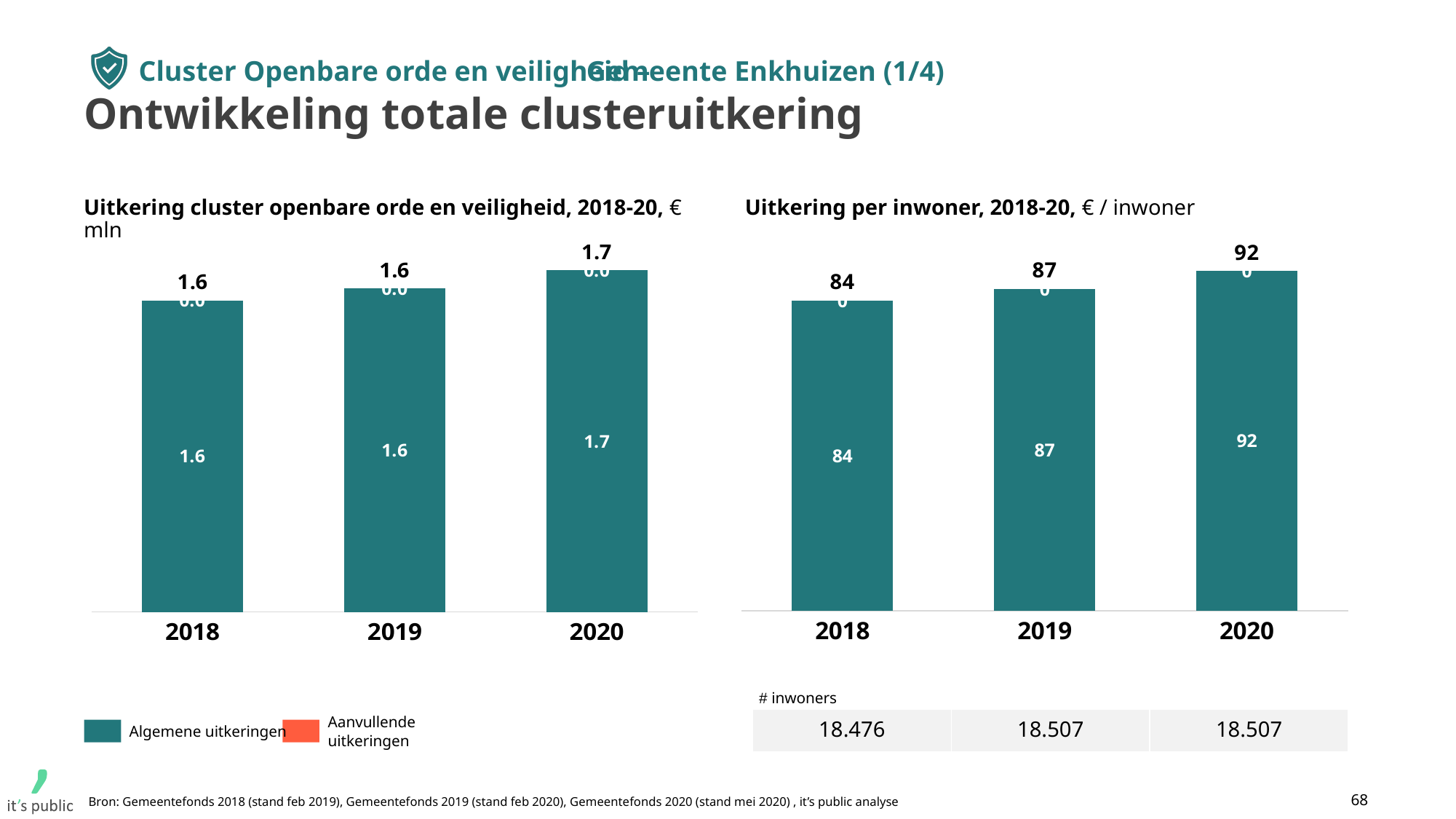
In the right chart (Uitkering per inwoner), do the values rise or fall from 2018 to 2020? Rise In the left chart (Uitkering cluster openbare orde en veiligheid), which is larger: the total for 2018 or the total for 2020? 2020 In the left chart (Uitkering cluster openbare orde en veiligheid), what is the total value for 2020? 1.7 What is the title of the right chart? Uitkering per inwoner, 2018-20, € / inwoner In the right chart (Uitkering per inwoner), what is the difference between the 2020 and 2018 values? 8 In the right chart (Uitkering per inwoner), which year has the highest value? 2020 In the right chart (Uitkering per inwoner), what is the value for 2019? 87 In the right chart (Uitkering per inwoner), which year has the lowest value? 2018 How many years are shown on the x axis of the left chart (Uitkering cluster openbare orde en veiligheid)? 3 What kind of chart is the right chart (Uitkering per inwoner)? Bar chart How many series does the legend of the left chart list? 2 In the left chart (Uitkering cluster openbare orde en veiligheid), what is the value of the Algemene uitkeringen segment for 2019? 1.6